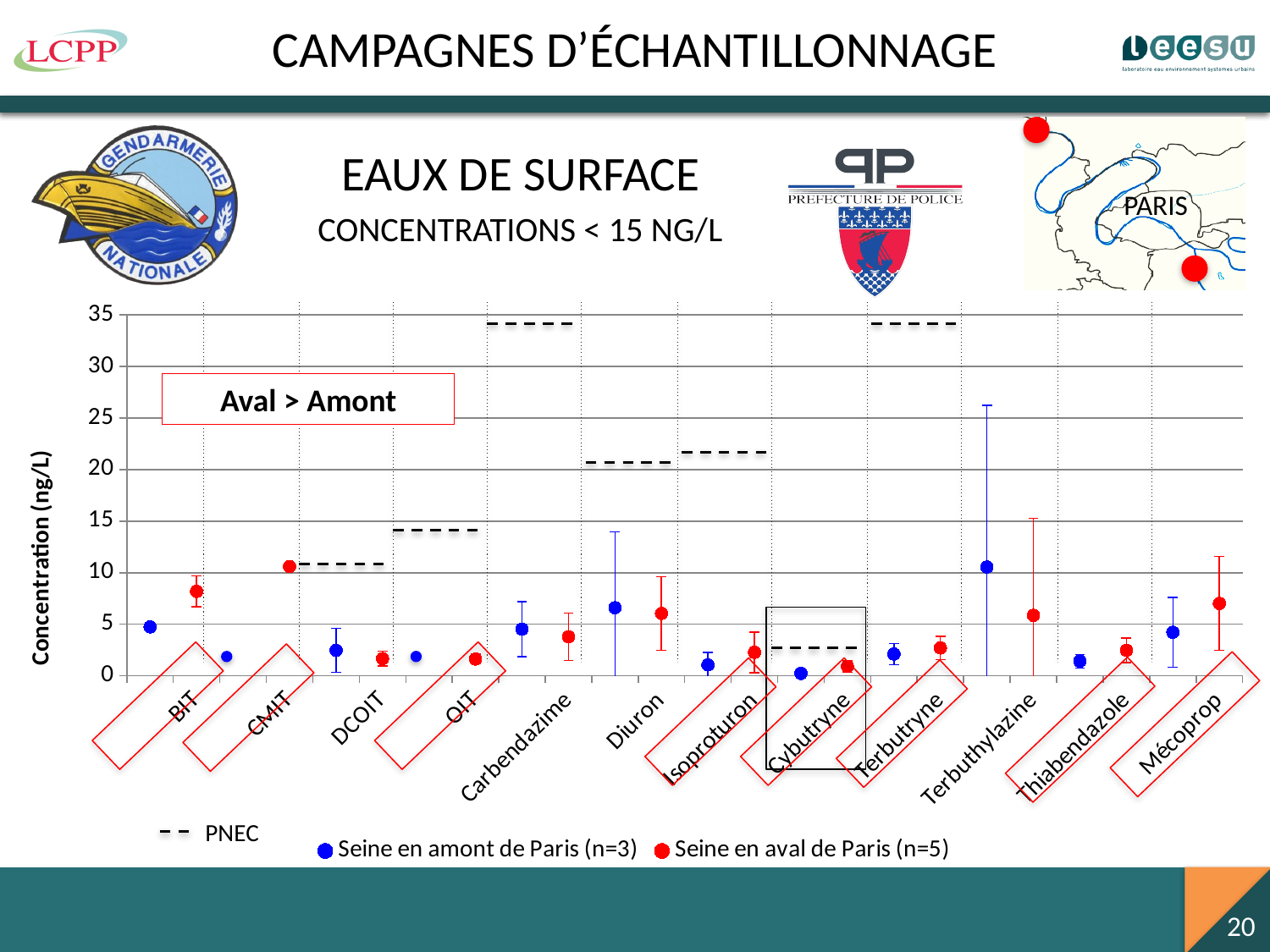
Is the 'Seine en aval de Paris' value for BIT greater or less than 5? greater Which compound has the lowest 'Seine en amont de Paris' value? Cybutryne For Terbuthylazine, which is larger: the 'Seine en amont de Paris' value or the 'Seine en aval de Paris' value? Seine en amont de Paris For BIT, which is larger: the 'Seine en amont de Paris' value or the 'Seine en aval de Paris' value? Seine en aval de Paris Is the 'Seine en amont de Paris' value for Terbuthylazine greater or less than 5? greater How many entries does the chart legend list? 3 Is the 'Seine en aval de Paris' value for Thiabendazole greater or less than 5? less What is the label of the y axis of the chart? Concentration (ng/L) Which colour represents 'Seine en aval de Paris (n=5)' in the chart? Red Which compound has the highest 'Seine en aval de Paris' value? CMIT How many compounds (categories) are shown along the x axis of the chart? 12